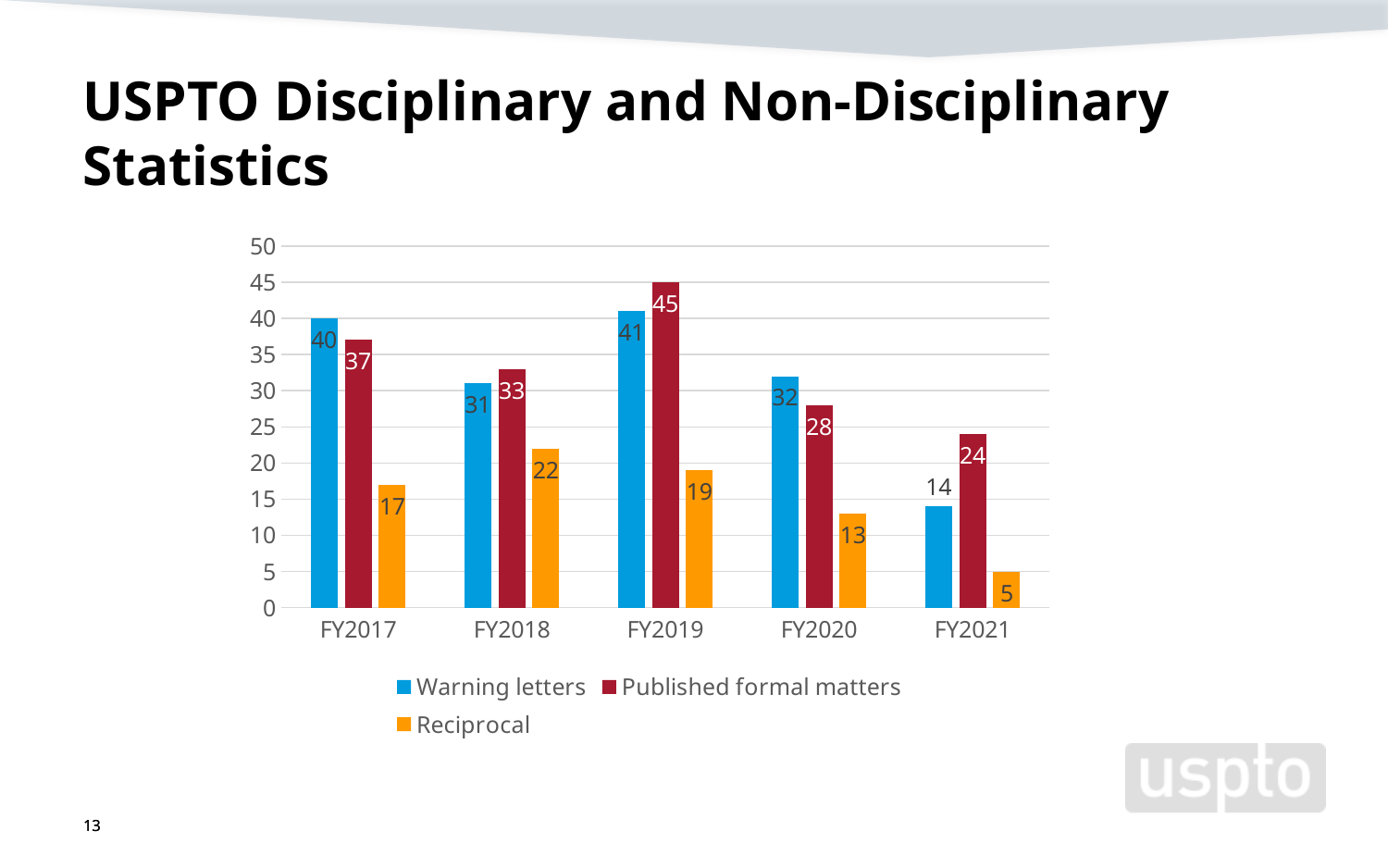
How many series does the legend list? 3 How many fiscal years are shown on the x axis? 5 Do the Reciprocal values rise or fall from FY2019 to FY2021? Fall What is the value for Reciprocal in FY2021? 5 Which fiscal year has the highest value for Published formal matters? FY2019 Which is larger in FY2018: Warning letters or Published formal matters? Published formal matters What is the value for Published formal matters in FY2020? 28 What is the difference between Warning letters and Published formal matters in FY2021? 10 Is the value for Reciprocal in FY2018 greater or less than 20? greater What kind of chart is shown on the slide? Bar chart What is the value for Warning letters in FY2019? 41 Which fiscal year has the lowest value for Warning letters? FY2021